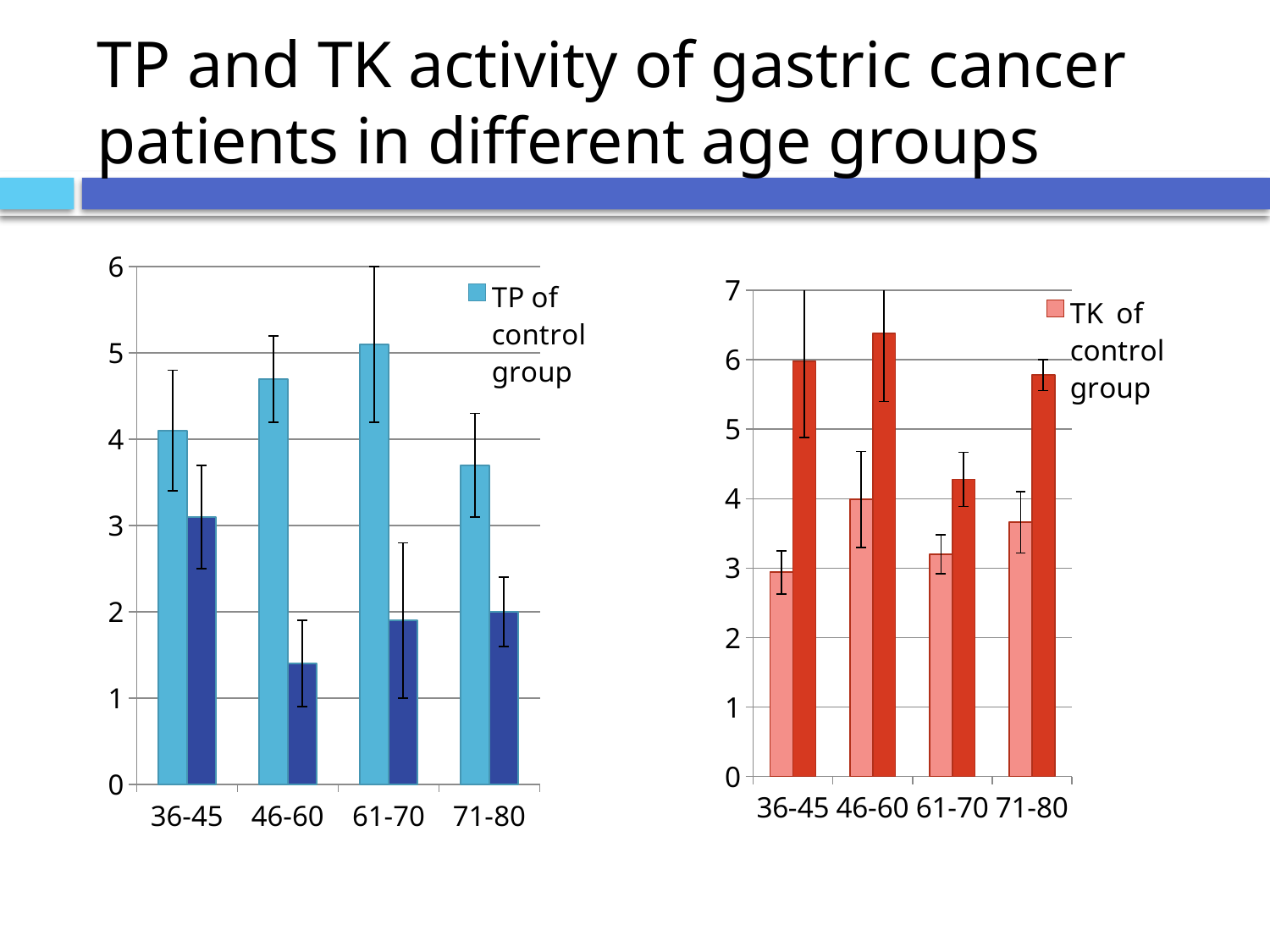
What kind of chart is the left chart (TP)? bar chart In the right chart (TK), is the value for TK of control group in the 61-70 age group greater or less than 4? less How many age groups are shown on the x axis of the left chart (TP)? 4 How many series does the legend of the left chart (TP) list? 1 What kind of chart is the right chart (TK)? bar chart In the right chart (TK), which age group has the highest value for TK of control group? 46-60 In the right chart (TK), which age group has the lowest dark red bar? 61-70 In the left chart (TP), is the value for TP of control group in the 46-60 age group greater or less than 4? greater In the left chart (TP), which age group has the highest value for TP of control group? 61-70 In the left chart (TP), is the dark blue bar for the 46-60 age group greater or less than 2? less In the left chart (TP), for the 36-45 age group, which is larger: the TP of control group bar or the dark blue bar? TP of control group In the left chart (TP), which age group has the lowest value for TP of control group? 71-80